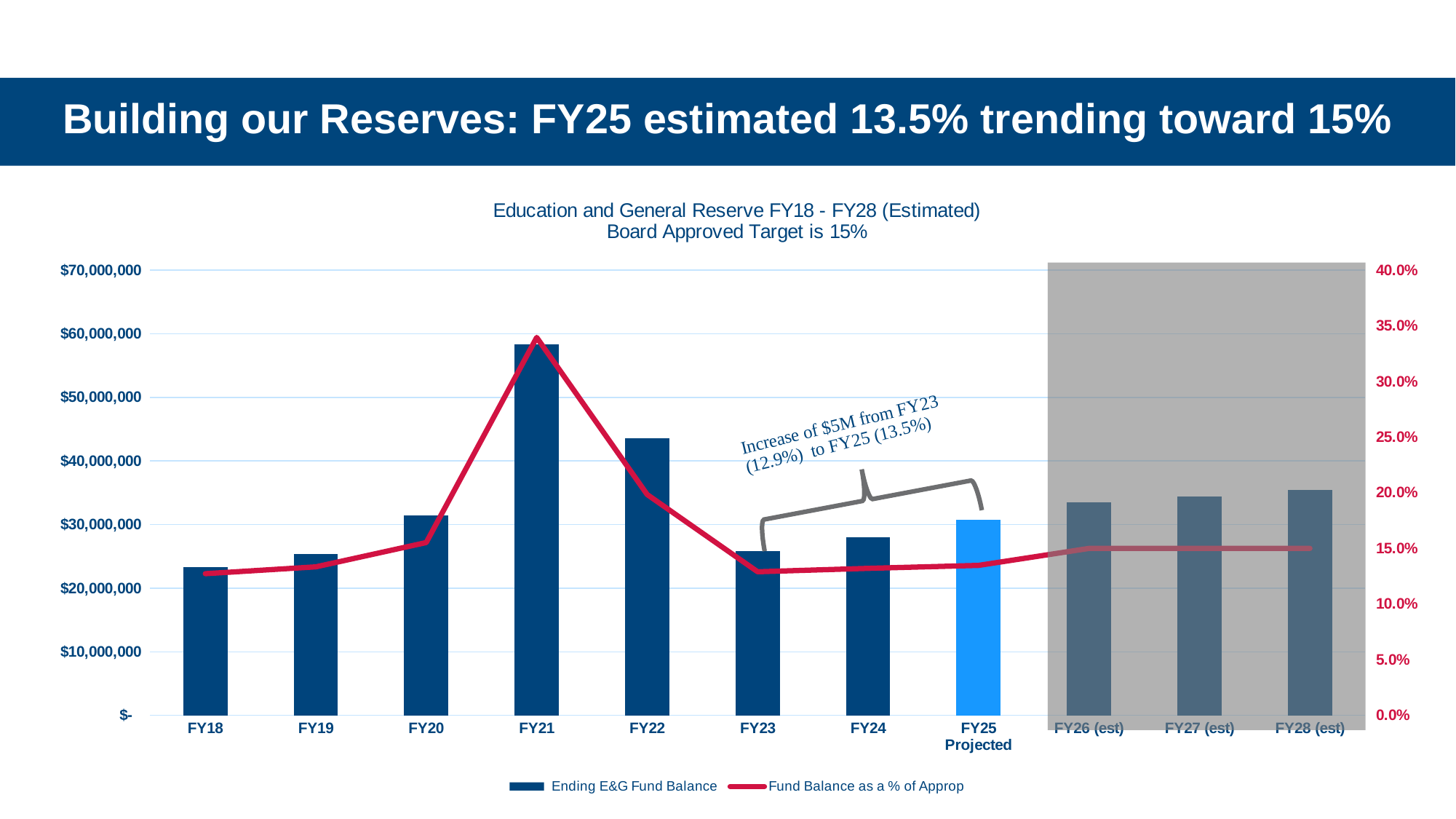
How many fiscal year categories are shown on the x axis? 11 Which fiscal year has the lowest Ending E&G Fund Balance bar? FY18 Is the Ending E&G Fund Balance for FY21 greater or less than $50,000,000? greater By how many percentage points does the Fund Balance as a % of Approp increase from FY23 to FY25 Projected? 0.6% Is the Fund Balance as a % of Approp for FY21 greater or less than 30.0%? greater What is the Fund Balance as a % of Approp for FY23, as stated in the annotation? 12.9% What is the title of the chart? Education and General Reserve FY18 - FY28 (Estimated) Board Approved Target is 15% What is the Fund Balance as a % of Approp for FY25 Projected, as stated in the annotation? 13.5% How many series does the chart legend list? 2 Which has the larger Ending E&G Fund Balance, FY22 or FY24? FY22 Which fiscal year has the highest Ending E&G Fund Balance bar? FY21 Do the Ending E&G Fund Balance bars rise or fall from FY21 to FY23? fall